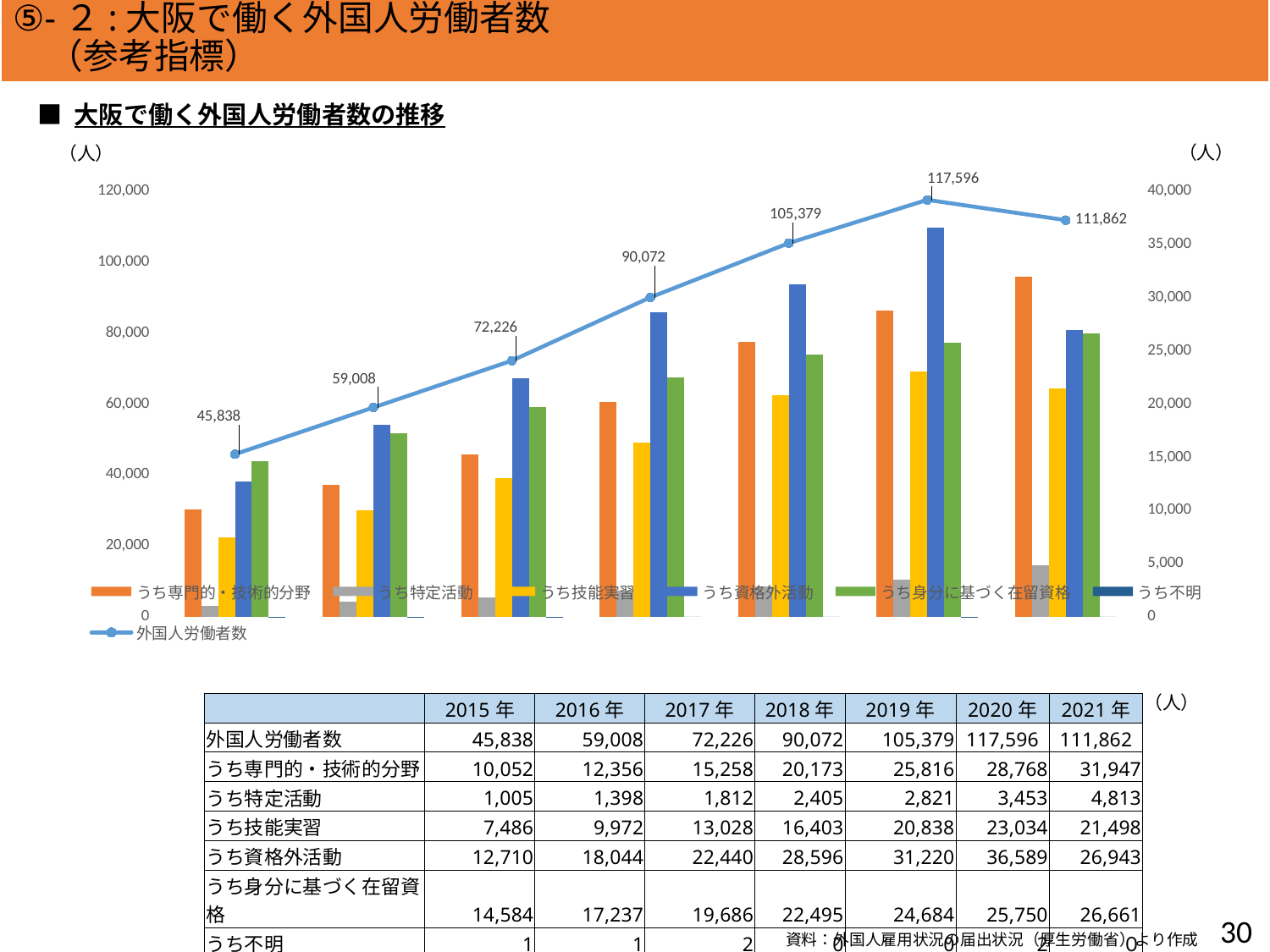
How many series does the legend list? 7 In which year does the 外国人労働者数 line reach its highest value? 2020年 What is the lowest value labelled on the 外国人労働者数 line? 45,838 What is the difference between the 2020年 and 2021年 values of 外国人労働者数? 5,734 Does the 外国人労働者数 line rise or fall from 2015年 to 2020年? Rise What is the highest value shown on the 外国人労働者数 line? 117,596 Which is larger, the 外国人労働者数 value for 2019年 or for 2018年? 2019年 What unit is shown at the top of the left axis? (人) What is the difference between the 2018年 and 2017年 values of 外国人労働者数? 17,846 What kind of chart is this? Combination bar and line chart Is the 2021年 bar for うち専門的・技術的分野 greater or less than 30,000 on the right axis? greater How many data points are plotted on the 外国人労働者数 line? 7